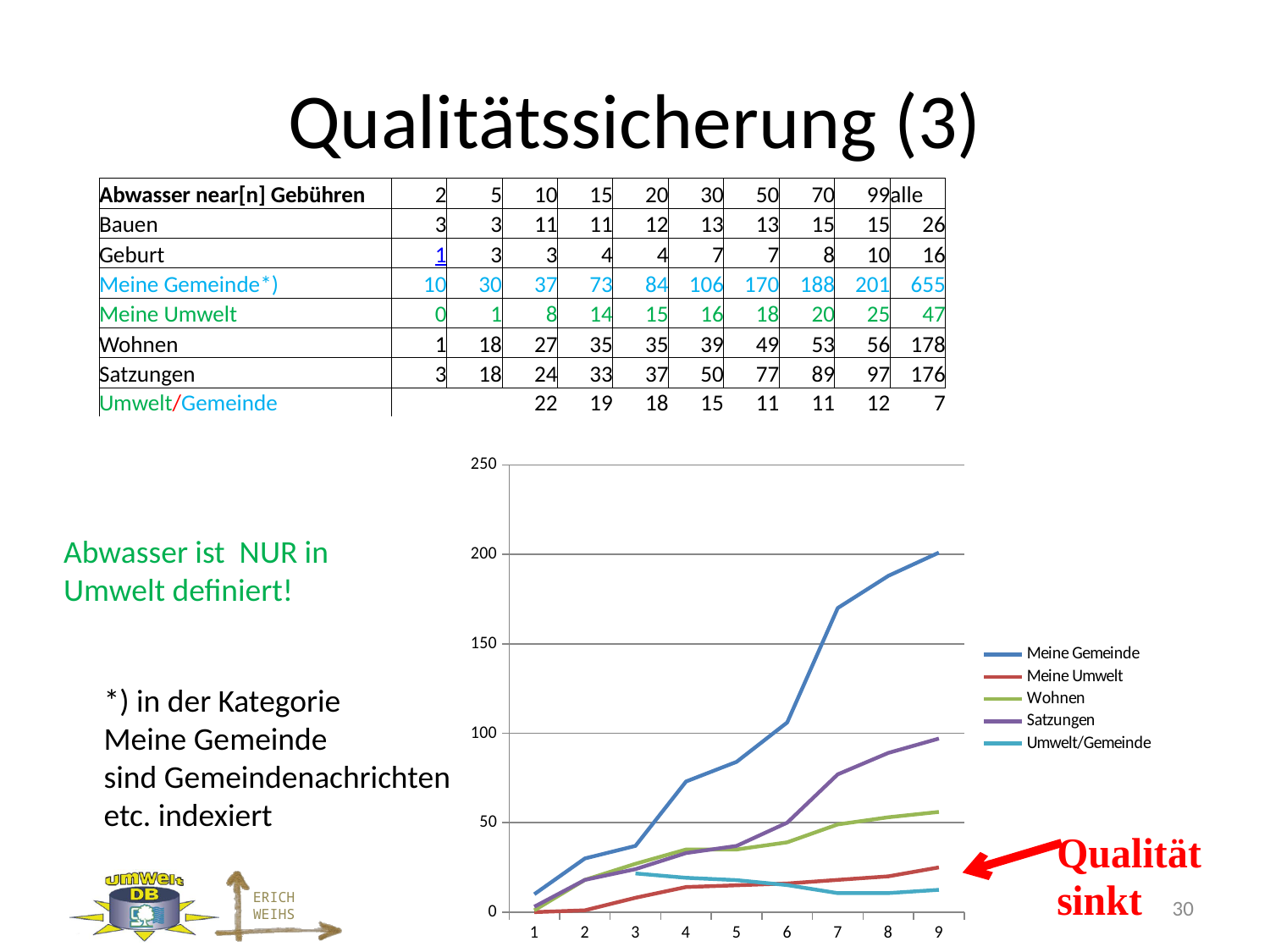
How many points are there along the x axis of the chart? 9 Does the Umwelt/Gemeinde line rise or fall from x = 3 to x = 9? fall What is the highest tick value shown on the chart's y axis? 250 Does the Meine Gemeinde line rise or fall along the x axis? rise Is the value for Wohnen at x = 9 greater or less than 100? less Which series has the lowest value at x = 9? Umwelt/Gemeinde Is the value for Meine Gemeinde at x = 9 greater or less than 150? greater Which series has the highest value at x = 9? Meine Gemeinde Is the value for Meine Gemeinde at x = 5 greater or less than 100? less At x = 7, which is larger: Satzungen or Wohnen? Satzungen What kind of chart is shown on the slide? line chart How many series does the chart's legend list? 5